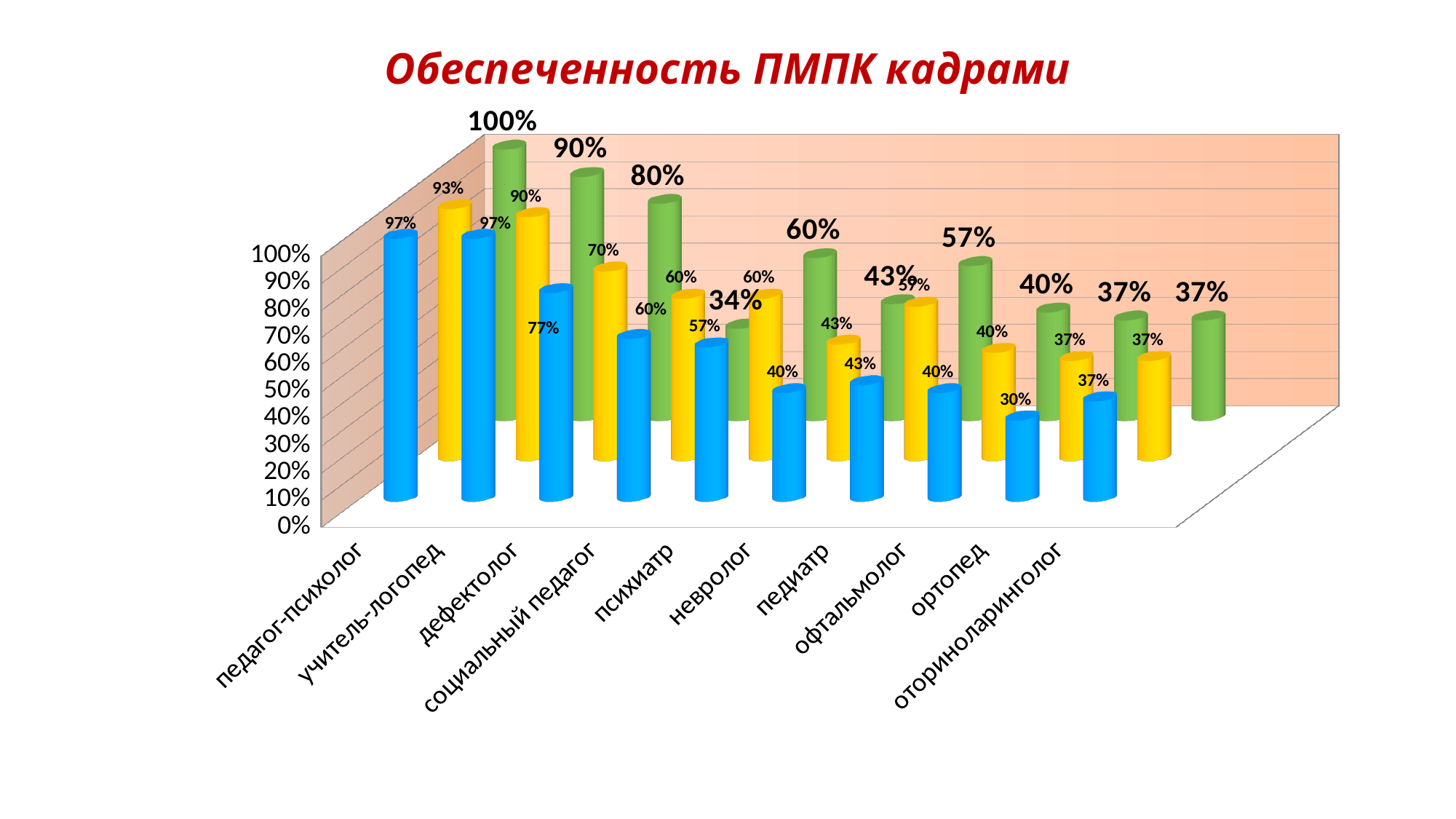
What is the value of the blue bar for дефектолог? 77% What is the title of the chart? Обеспеченность ПМПК кадрами Which category has the lowest blue bar? ортопед What kind of chart is shown on the slide? bar chart What is the value of the green bar for педагог-психолог? 100% What is the difference between the blue bar for педагог-психолог and the blue bar for ортопед? 67% Do the blue bar values generally rise or fall from left to right along the x axis? fall What is the value of the yellow bar for учитель-логопед? 90% How many categories are shown along the x axis? 10 Which category has the highest green bar? педагог-психолог What is the value of the blue bar for ортопед? 30% What is the value of the blue bar for педагог-психолог? 97%